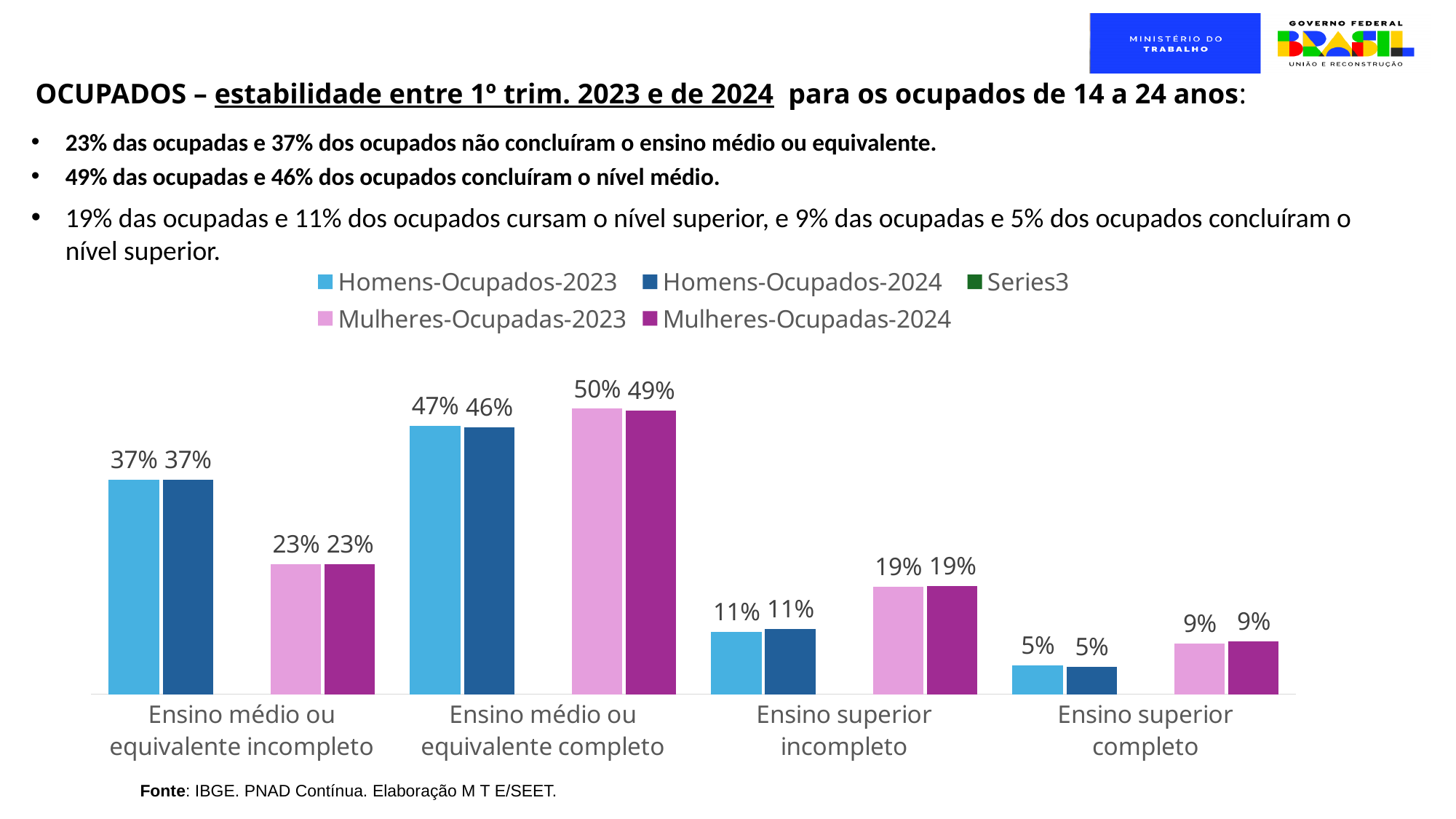
In the 'Ensino superior incompleto' category, which is larger: Homens-Ocupados-2024 or Mulheres-Ocupadas-2024? Mulheres-Ocupadas-2024 What is the value for Homens-Ocupados-2023 in the 'Ensino médio ou equivalente incompleto' category? 37% What kind of chart is shown on the slide? Bar chart Which category has the lowest value for Homens-Ocupados-2024? Ensino superior completo Which category has the highest value for Mulheres-Ocupadas-2023? Ensino médio ou equivalente completo What is the value for Mulheres-Ocupadas-2024 in the 'Ensino médio ou equivalente completo' category? 49% How many series does the chart legend list? 5 What is the value for Mulheres-Ocupadas-2023 in the 'Ensino superior completo' category? 9% What is the difference between Homens-Ocupados-2023 and Homens-Ocupados-2024 in the 'Ensino médio ou equivalente completo' category? 1% What is the difference between Homens-Ocupados-2023 and Mulheres-Ocupadas-2023 in the 'Ensino médio ou equivalente incompleto' category? 14% What is the value for Homens-Ocupados-2024 in the 'Ensino superior incompleto' category? 11% How many categories are shown on the x axis of the chart? 4